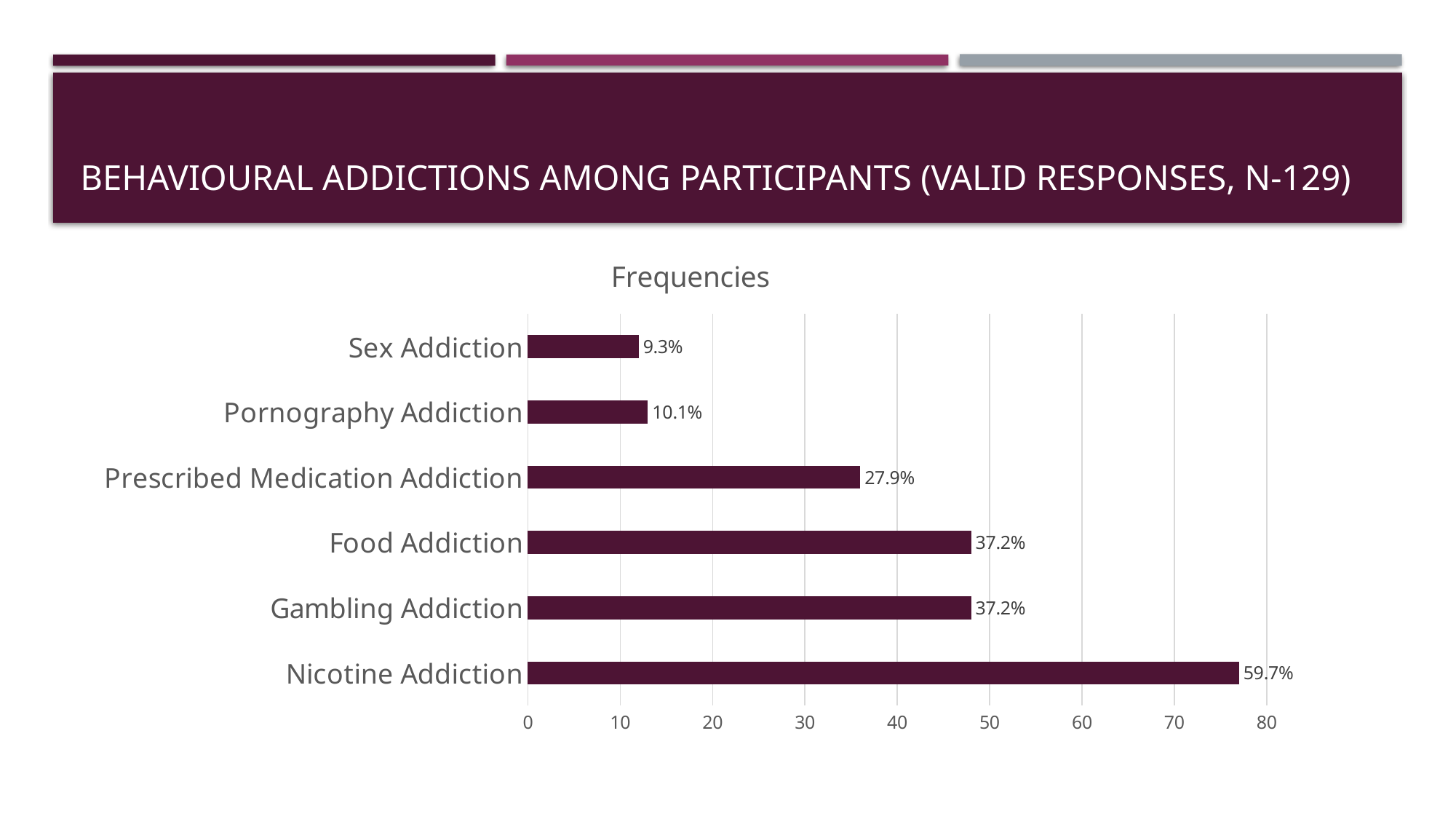
Is the bar for Nicotine Addiction greater or less than 70 on the axis? greater Which is larger, the value for Prescribed Medication Addiction or the value for Gambling Addiction? Gambling Addiction What is the difference in percentage points between the labels for Nicotine Addiction and Food Addiction? 22.5 What is the data label shown for Pornography Addiction? 10.1% Which category has the lowest value? Sex Addiction What is the data label shown for Nicotine Addiction? 59.7% What is the data label shown for Prescribed Medication Addiction? 27.9% Which category has the highest value? Nicotine Addiction How many categories are shown in the chart? 6 What is the data label shown for Sex Addiction? 9.3% What kind of chart is shown on the slide? Bar chart Is the bar for Food Addiction greater or less than 50 on the axis? less